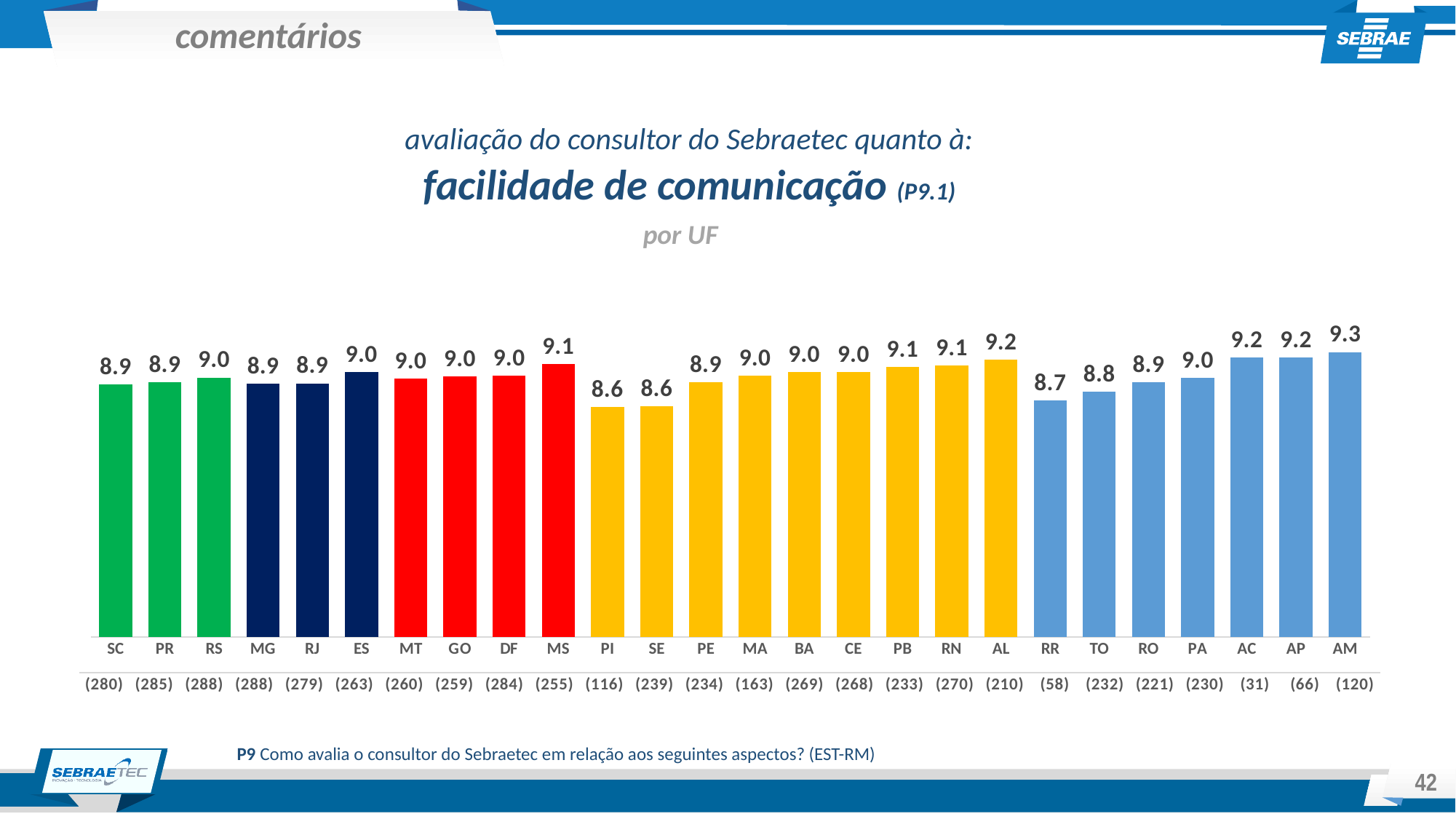
Which UF has the highest value? AM Which is larger, the value for TO or the value for AC? AC What is the difference between the values for AL and RR? 0.5 What value is shown for RR? 8.7 What number is shown in parentheses below the RR bar? (58) How many UFs (bars) are shown on the chart? 26 What kind of chart is shown on the slide? Bar chart What value is shown for MS? 9.1 What value is shown for TO? 8.8 What value is shown for AM? 9.3 What is the difference between the values for AM and PI? 0.7 What is the lowest value shown on the chart? 8.6